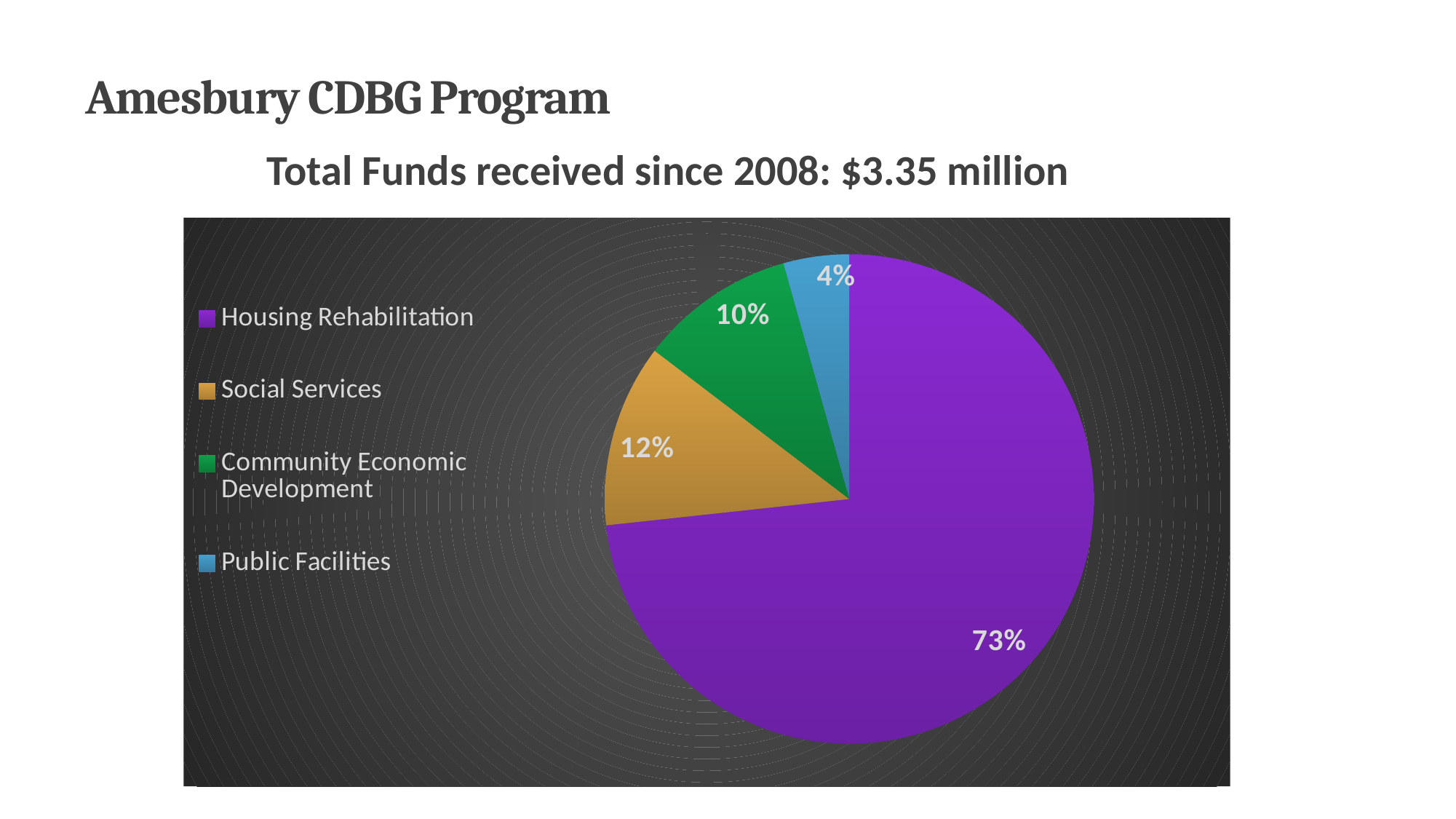
What share of the pie does Social Services take? 12% What share of the pie does Public Facilities take? 4% What kind of chart is shown on the slide? pie chart What share of the pie does Community Economic Development take? 10% How many categories does the pie chart show? 4 What colour is the Community Economic Development slice? green What total amount of funds received since 2008 is stated above the chart? $3.35 million Which category has the smallest slice of the pie? Public Facilities Which is larger, the share for Social Services or the share for Community Economic Development? Social Services Which category has the largest slice of the pie? Housing Rehabilitation What is the difference in percentage points between Housing Rehabilitation and Social Services? 61